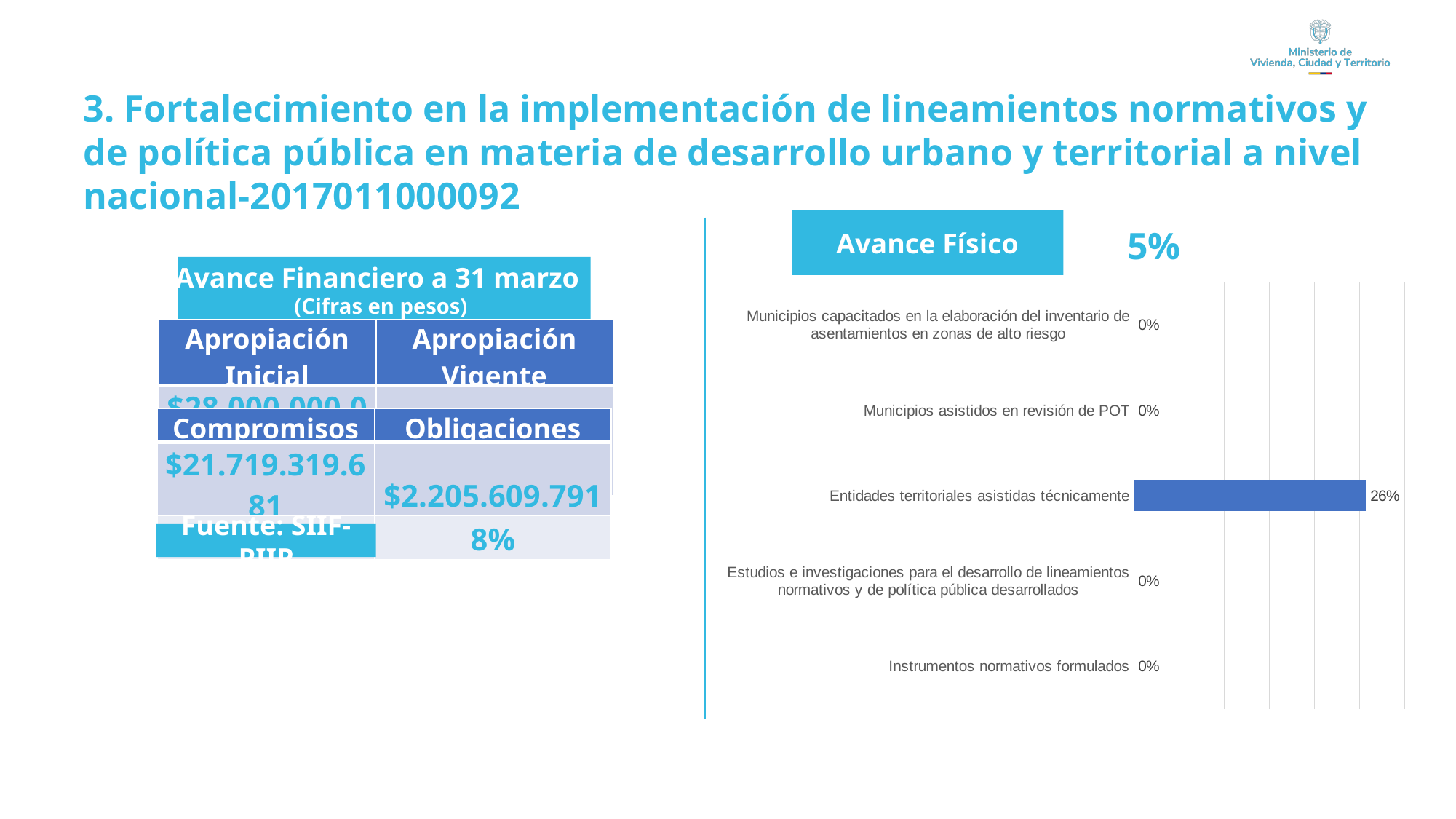
What kind of chart is the Avance Físico chart? Bar chart What is the value for Municipios capacitados en la elaboración del inventario de asentamientos en zonas de alto riesgo in the Avance Físico chart? 0% How many categories in the Avance Físico chart have a value of 0%? 4 Which category has the highest value in the Avance Físico chart? Entidades territoriales asistidas técnicamente What is the title of the chart on the right side of the slide? Avance Físico How many categories are shown in the Avance Físico chart? 5 What is the value for Entidades territoriales asistidas técnicamente in the Avance Físico chart? 26% In the Avance Físico chart, which is larger: the value for Entidades territoriales asistidas técnicamente or the value for Estudios e investigaciones para el desarrollo de lineamientos normativos y de política pública desarrollados? Entidades territoriales asistidas técnicamente What overall percentage is shown next to the Avance Físico chart title? 5% What is the value for Instrumentos normativos formulados in the Avance Físico chart? 0% What is the value for Municipios asistidos en revisión de POT in the Avance Físico chart? 0% In the Avance Físico chart, what is the difference between the value for Entidades territoriales asistidas técnicamente and the value for Municipios asistidos en revisión de POT? 26%